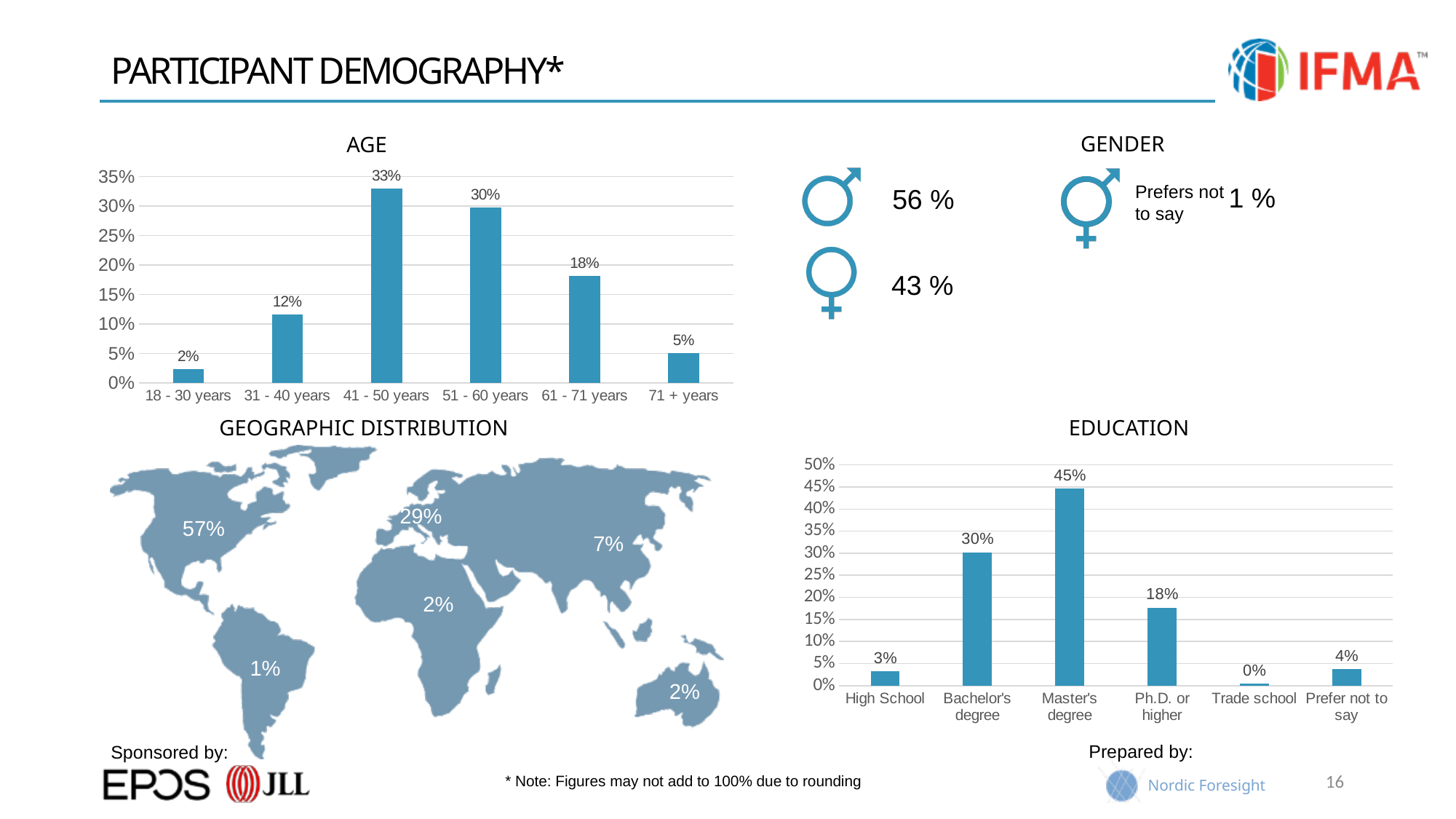
In the AGE chart, which age group has the lowest value? 18 - 30 years In the EDUCATION chart, what is the value for Bachelor's degree? 30% In the EDUCATION chart, which is larger, the value for High School or the value for Prefer not to say? Prefer not to say In the AGE chart, what is the difference between the values for 51 - 60 years and 61 - 71 years? 12% In the AGE chart, is the value for 31 - 40 years greater or less than 10%? greater In the EDUCATION chart, what is the difference between the values for Master's degree and Ph.D. or higher? 27% In the GENDER section, what is the value shown for male participants? 56 % What kind of chart is the EDUCATION chart? Bar chart In the GEOGRAPHIC DISTRIBUTION map, what is the value shown for North America? 57% In the AGE chart, what is the value for 41 - 50 years? 33% In the AGE chart, how many age categories are shown? 6 In the EDUCATION chart, which category has the highest value? Master's degree